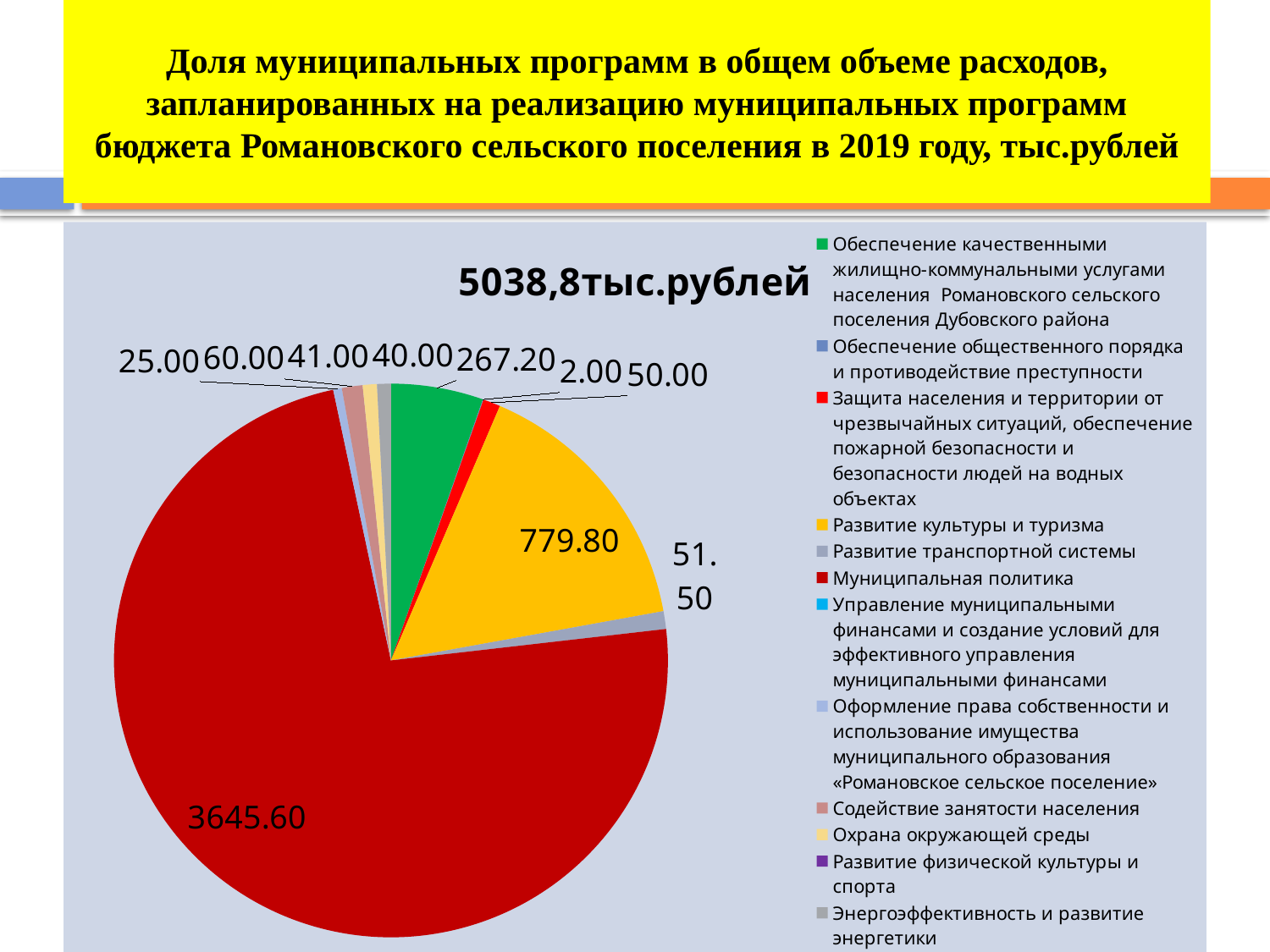
What colour is the slice for Муниципальная политика? dark red Which is larger: the slice for Муниципальная политика or the slice for Развитие культуры и туризма? Муниципальная политика What is the difference between the Муниципальная политика slice (3645.60) and the Развитие культуры и туризма slice (779.80)? 2865.80 What is the value for Развитие культуры и туризма? 779.80 Which program has the largest slice of the pie? Муниципальная политика What total amount is shown in the chart title? 5038,8тыс.рублей What is the value for Обеспечение качественными жилищно-коммунальными услугами населения Романовского сельского поселения Дубовского района? 267.20 How many entries does the chart legend list? 12 What is the value of the largest slice, Муниципальная политика? 3645.60 What is the smallest data label printed on the pie chart? 2.00 What kind of chart is shown on the slide? pie chart